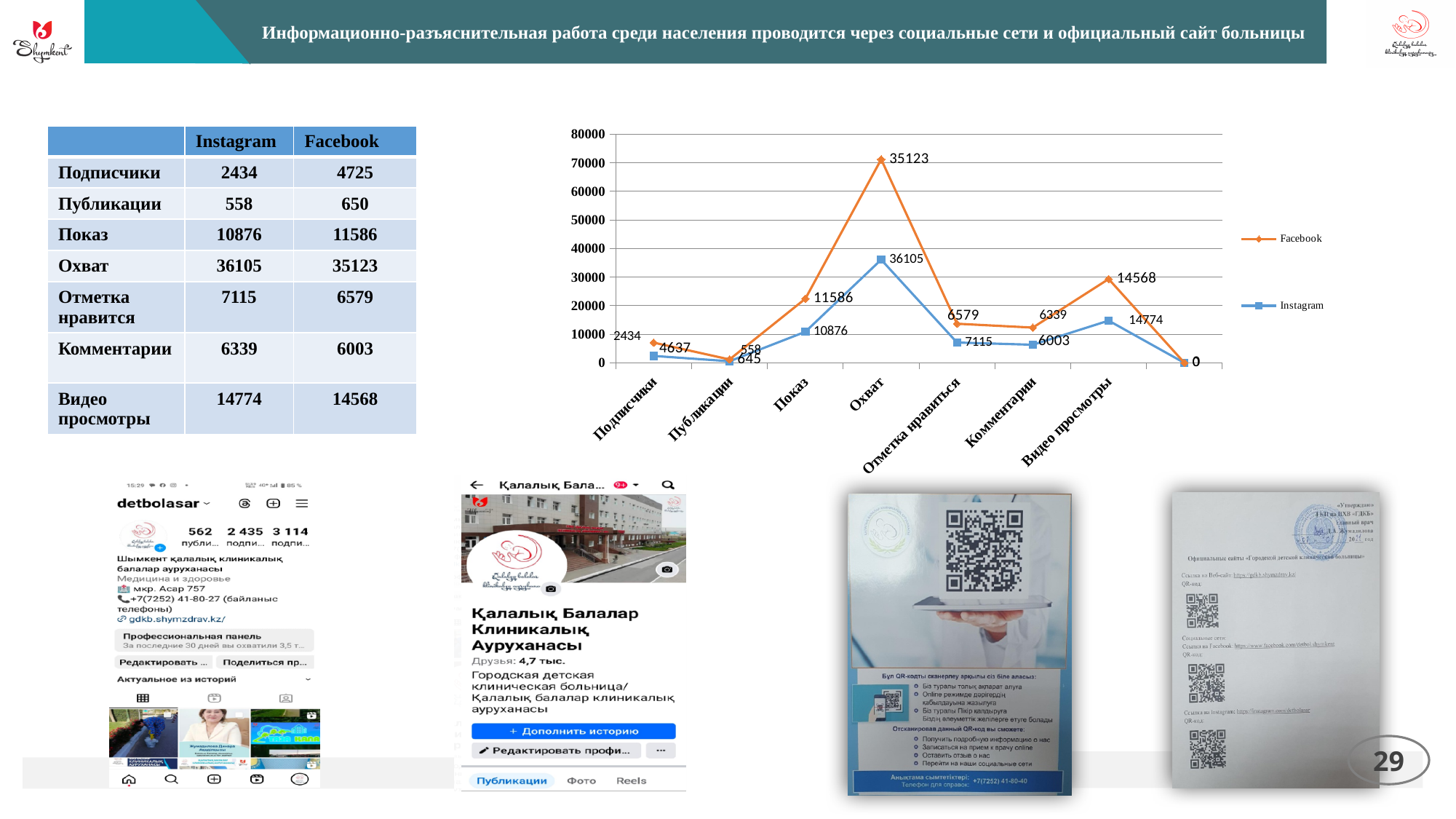
What is the difference between the Facebook and Instagram labelled values at Показ? 710 Which series is drawn in orange on the chart? Facebook What is the Facebook value labelled at Комментарии on the chart? 6003 What is the difference between the Instagram and Facebook labelled values at Видео просмотры? 206 What kind of chart is shown on the slide? line chart At which category does the Instagram series have its highest labelled value? Охват What is the Facebook value labelled at Показ on the chart? 11586 What is the Facebook value labelled at Отметка нравится on the chart? 6579 What is the Instagram value labelled at Охват on the chart? 36105 What is the Instagram value labelled at Видео просмотры on the chart? 14774 At Охват, which series has the larger labelled value, Facebook or Instagram? Instagram How many series does the chart legend list? 2